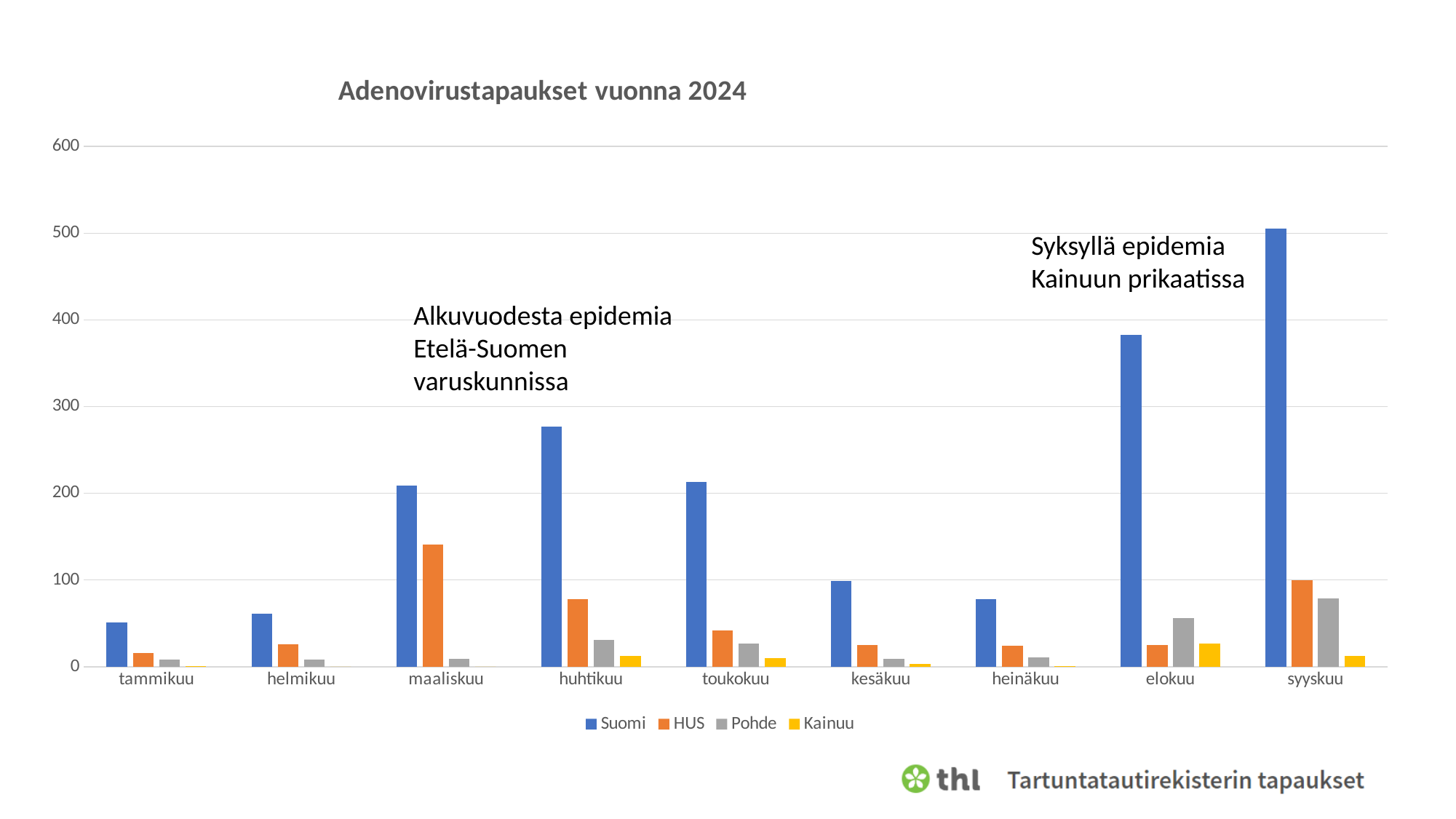
In which month is the Pohde value highest? syyskuu How many series does the legend list? 4 How many months are shown on the x axis? 9 Do the Suomi values rise or fall from heinäkuu to syyskuu? rise In which month is the HUS value highest? maaliskuu In which month is the Suomi value highest? syyskuu What kind of chart is shown on the slide? bar chart What is the title of the chart? Adenovirustapaukset vuonna 2024 Which is larger, the Suomi value for huhtikuu or for toukokuu? huhtikuu Is the Suomi value for elokuu greater or less than 400? less Is the Suomi value for syyskuu greater or less than 400? greater